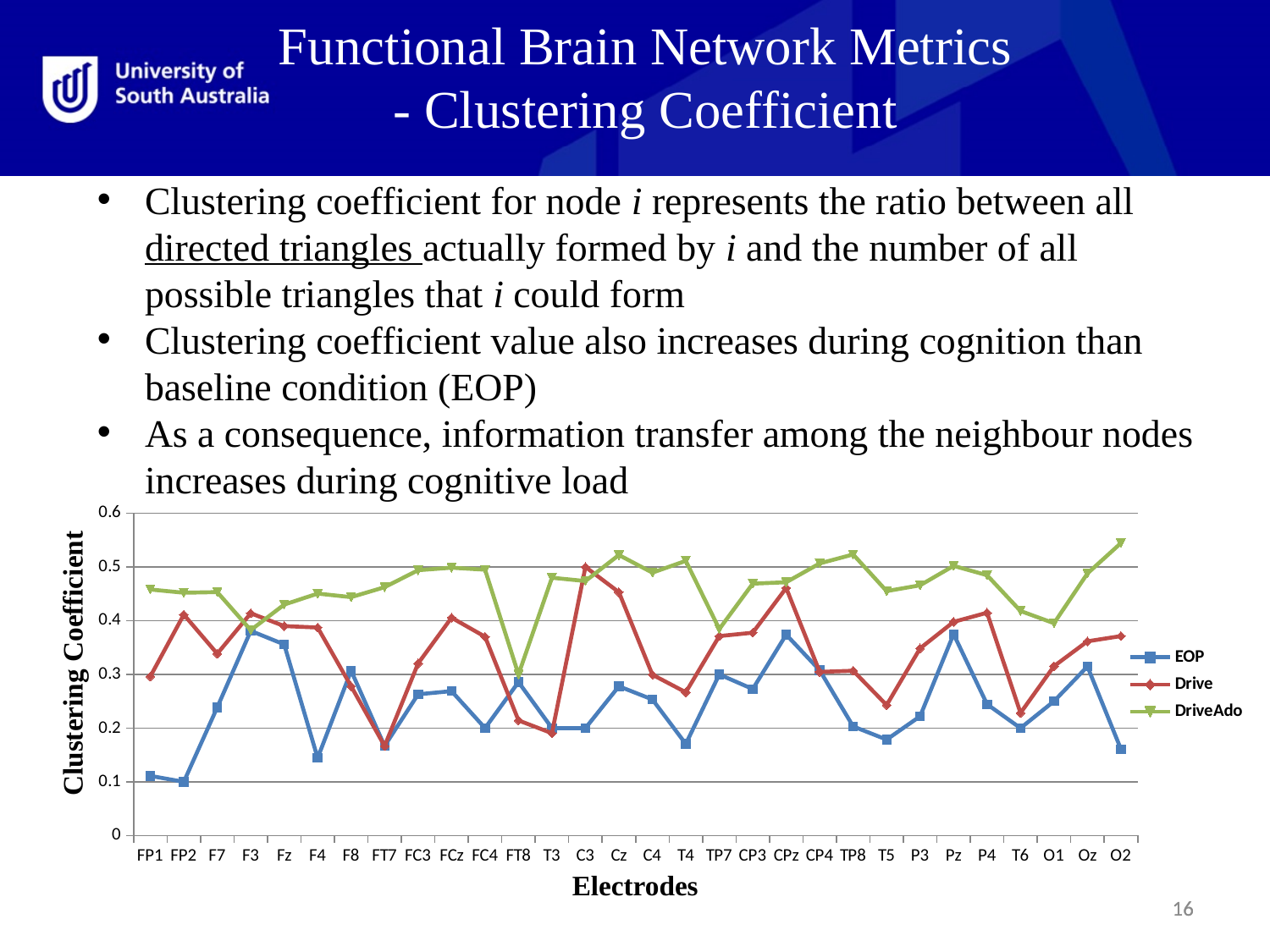
Is the DriveAdo value at O2 greater or less than 0.5? greater Is the DriveAdo value at FT8 greater or less than 0.4? less Is the Drive value at FT7 greater or less than 0.2? less At electrode T3, which series has the larger value, Drive or DriveAdo? DriveAdo At electrode FP1, which series has the larger value, EOP or DriveAdo? DriveAdo How many series does the chart's legend list? 3 Which series are listed in the chart's legend? EOP, Drive, DriveAdo What is the title of the chart's y axis? Clustering Coefficient How many electrodes are plotted along the x axis of the chart? 30 What kind of chart is shown on the slide? Line chart